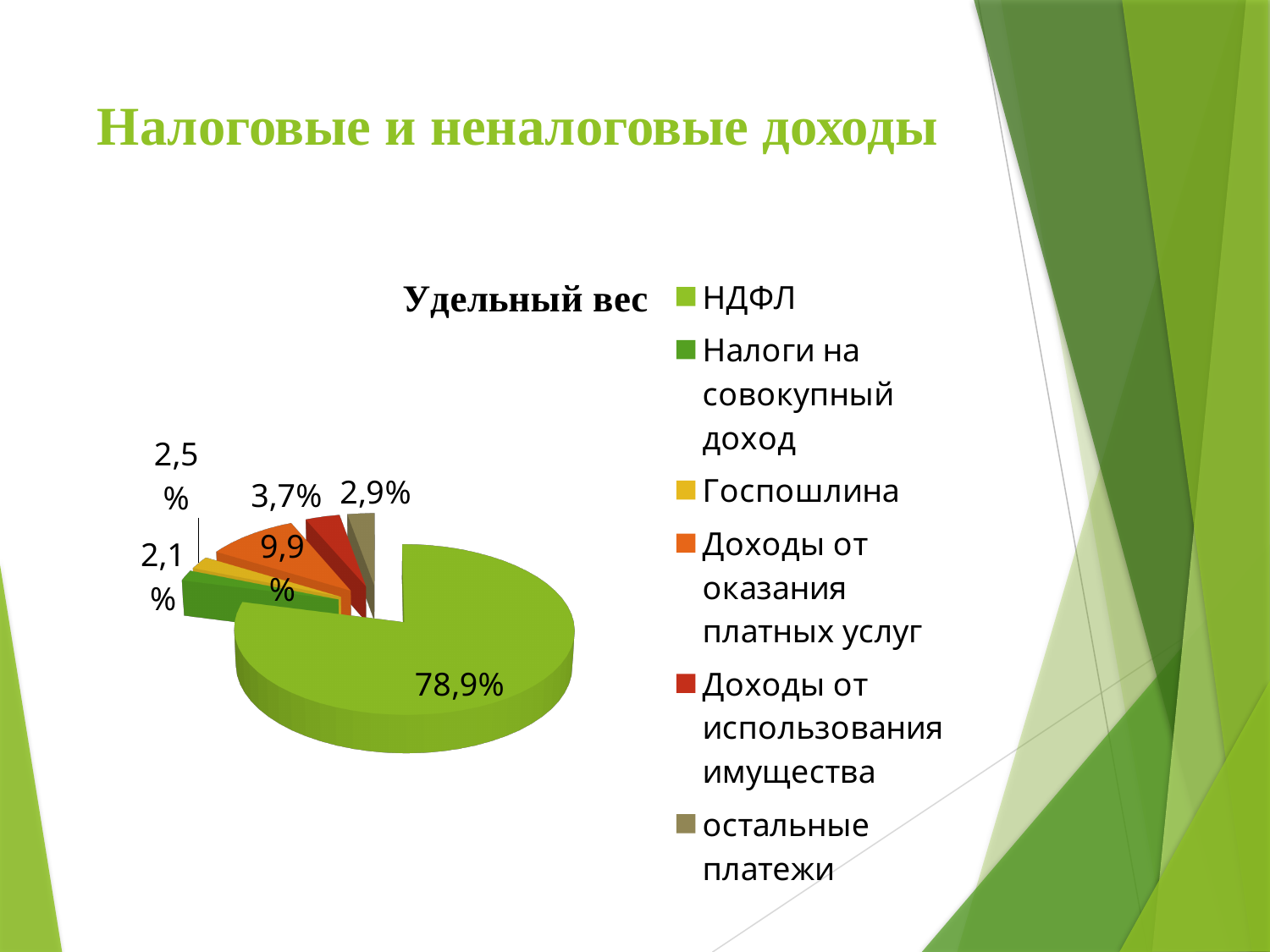
Which category has the largest share of the pie? НДФЛ What is the value shown for Доходы от использования имущества? 3,7% How many categories does the legend of the chart list? 6 What is the value shown for Госпошлина? 2,5% What is the difference between the share for НДФЛ and the share for Доходы от оказания платных услуг? 69,0% What share of the pie does НДФЛ have? 78,9% Which is larger: the share for Доходы от оказания платных услуг or the share for Доходы от использования имущества? Доходы от оказания платных услуг What type of chart is shown on the slide? pie chart What is the value shown for остальные платежи? 2,9% What is the value shown for Доходы от оказания платных услуг? 9,9% Which category has the smallest share of the pie? Налоги на совокупный доход What is the title of the chart? Удельный вес